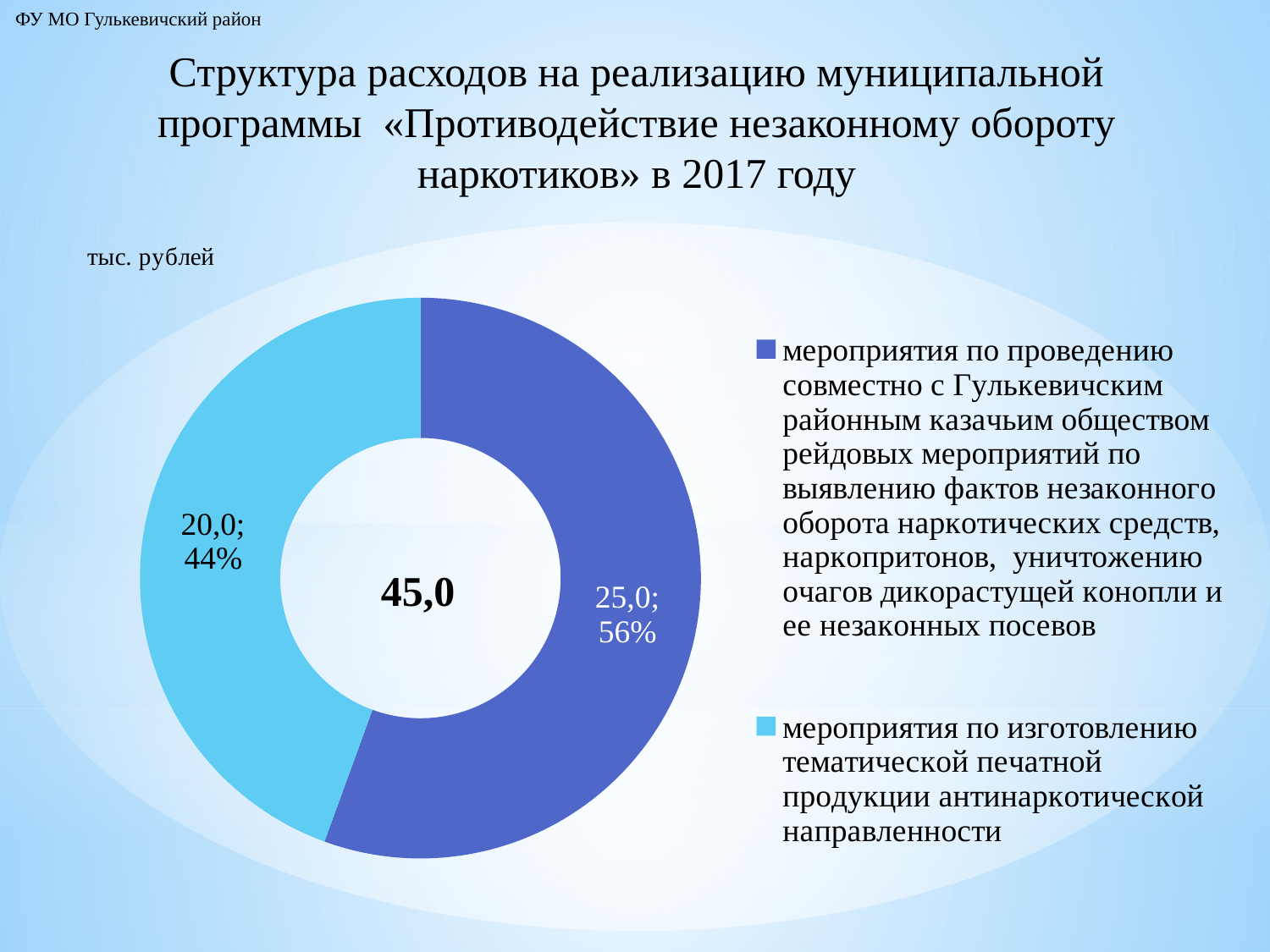
What is the value for the slice "мероприятия по изготовлению тематической печатной продукции антинаркотической направленности"? 20,0 What total value is shown in the centre of the doughnut? 45,0 Which is larger: the slice for raid events (рейдовых мероприятий) or the slice for printed products (печатной продукции)? рейдовых мероприятий (25,0) What is the value for the slice "мероприятия по проведению совместно с Гулькевичским районным казачьим обществом рейдовых мероприятий..."? 25,0 Which category has the smallest slice? мероприятия по изготовлению тематической печатной продукции антинаркотической направленности What share of the total does the slice for raid events with the Cossack society (рейдовых мероприятий) represent? 56% Which category has the largest slice? мероприятия по проведению совместно с Гулькевичским районным казачьим обществом рейдовых мероприятий What share of the total does the slice for printed anti-drug products (печатной продукции) represent? 44% What type of chart is shown on the slide? doughnut (pie) chart What is the difference between the two slice values, 25,0 and 20,0? 5,0 In what units are the chart values given? тыс. рублей How many slices does the chart have? 2